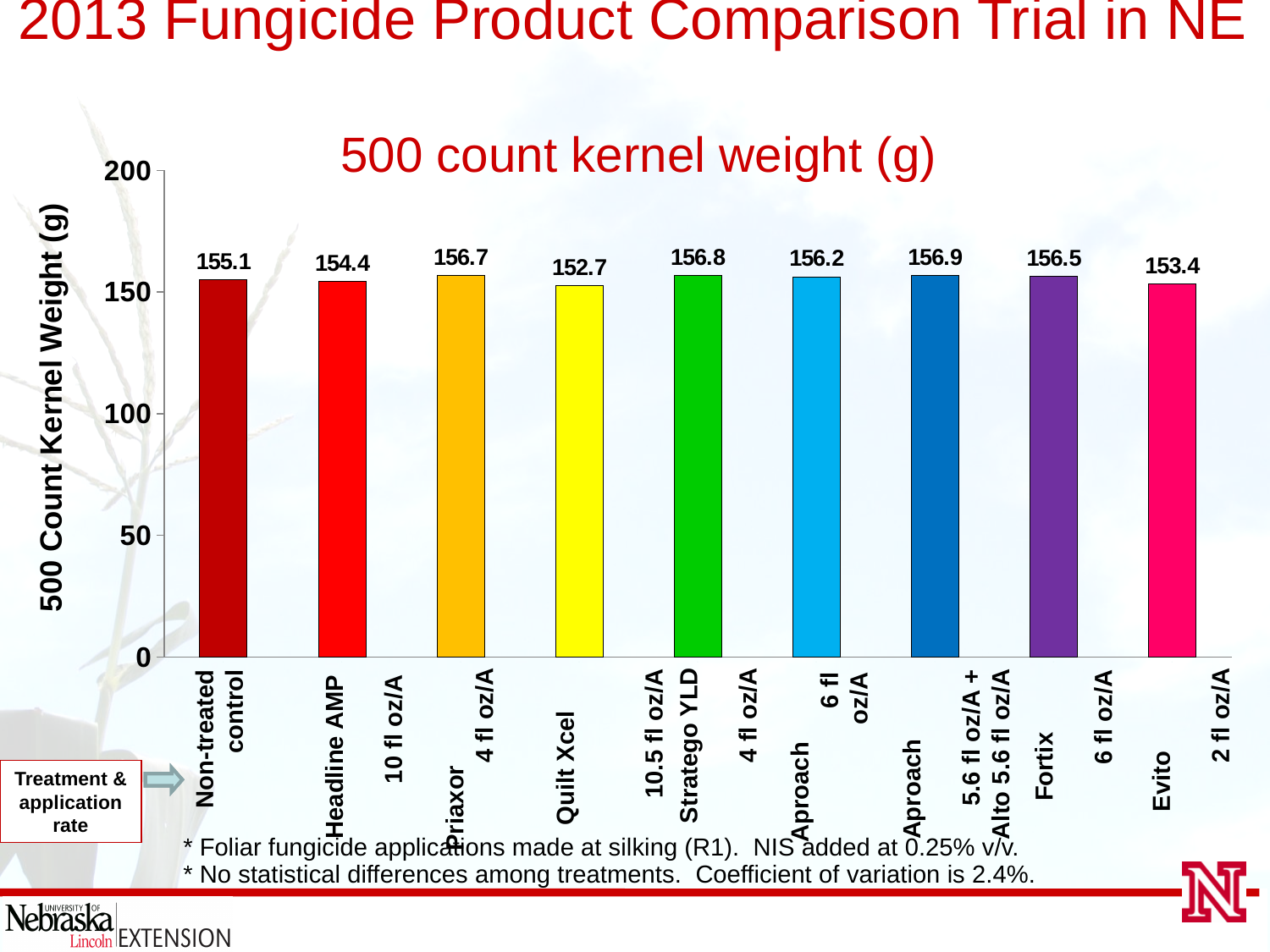
Which treatment has the highest 500 count kernel weight? Aproach 5.6 fl oz/A + Alto 5.6 fl oz/A What is the difference in 500 count kernel weight between the Non-treated control and Quilt Xcel? 2.4 Which treatment has the lowest 500 count kernel weight? Quilt Xcel Is the 500 count kernel weight for Fortix greater or less than 100? greater What is the 500 count kernel weight for the Non-treated control? 155.1 What is the 500 count kernel weight for Stratego YLD? 156.8 What is the title of the chart? 500 count kernel weight (g) What is the 500 count kernel weight for Evito? 153.4 What type of chart is shown on the slide? bar chart How many treatments are shown in the chart? 9 Which has a higher 500 count kernel weight, Priaxor or Headline AMP? Priaxor What is the 500 count kernel weight for Quilt Xcel? 152.7